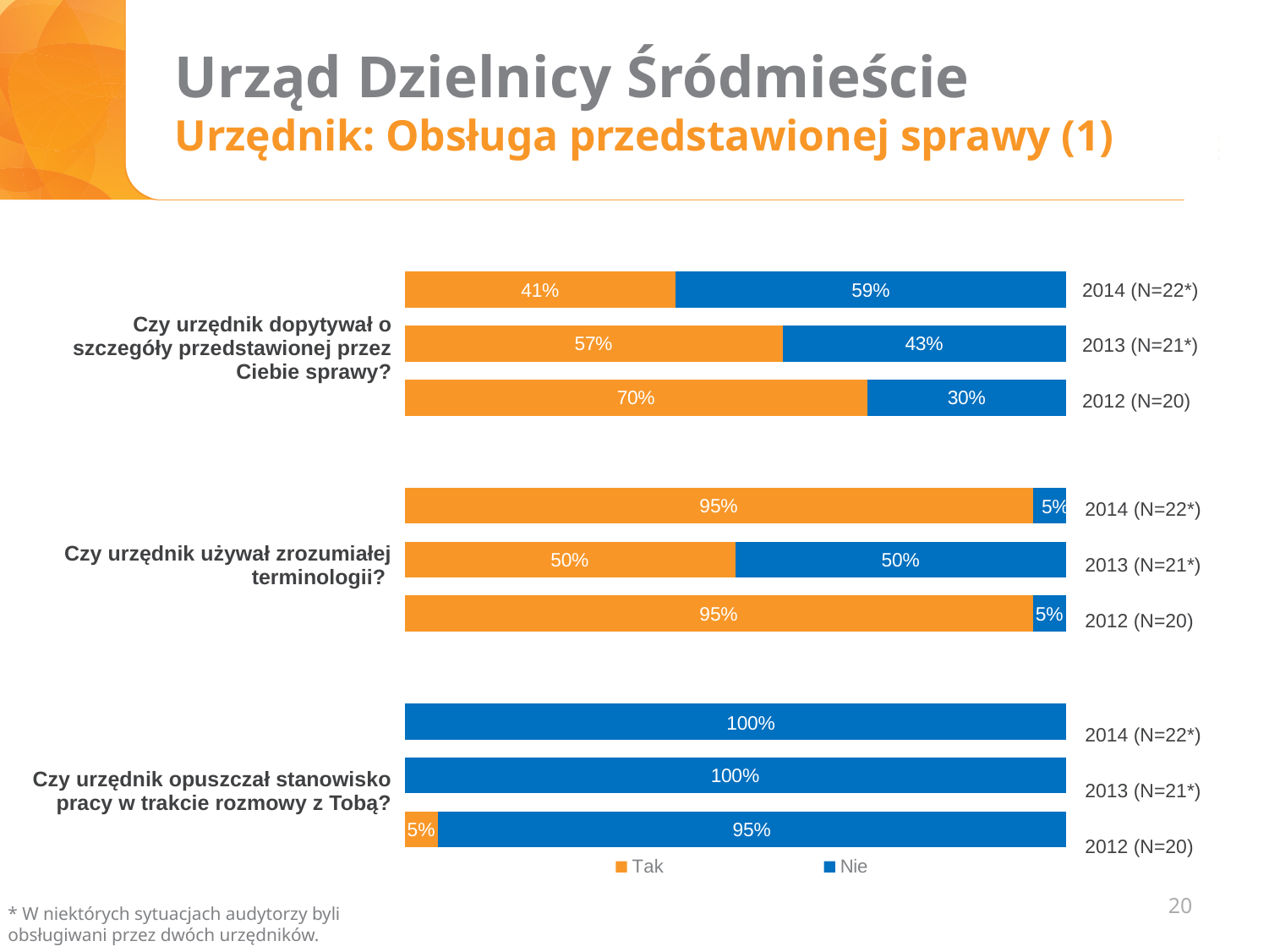
In the chart for "Czy urzędnik opuszczał stanowisko pracy w trakcie rozmowy z Tobą?", what is the "Nie" value for 2013 (N=21*)? 100% In the chart for "Czy urzędnik opuszczał stanowisko pracy w trakcie rozmowy z Tobą?", what is the "Tak" value for 2012 (N=20)? 5% In the chart for "Czy urzędnik dopytywał o szczegóły przedstawionej przez Ciebie sprawy?", what is the "Tak" value for 2014 (N=22*)? 41% In the chart for "Czy urzędnik dopytywał o szczegóły przedstawionej przez Ciebie sprawy?", does the "Tak" value rise or fall from 2012 to 2014? fall In the chart for "Czy urzędnik dopytywał o szczegóły przedstawionej przez Ciebie sprawy?", what is the difference between the "Tak" values for 2012 (N=20) and 2014 (N=22*)? 29% In the chart for "Czy urzędnik używał zrozumiałej terminologii?", what is the "Tak" value for 2013 (N=21*)? 50% In the chart for "Czy urzędnik dopytywał o szczegóły przedstawionej przez Ciebie sprawy?", which year has the highest "Tak" value? 2012 (N=20) What kind of chart is used on the slide? stacked bar chart How many series does the legend list? 2 In the chart for "Czy urzędnik używał zrozumiałej terminologii?", which year has the lowest "Tak" value? 2013 (N=21*) In the chart for "Czy urzędnik używał zrozumiałej terminologii?", what is the "Nie" value for 2014 (N=22*)? 5% In the chart for "Czy urzędnik dopytywał o szczegóły przedstawionej przez Ciebie sprawy?", what is the "Nie" value for 2012 (N=20)? 30%